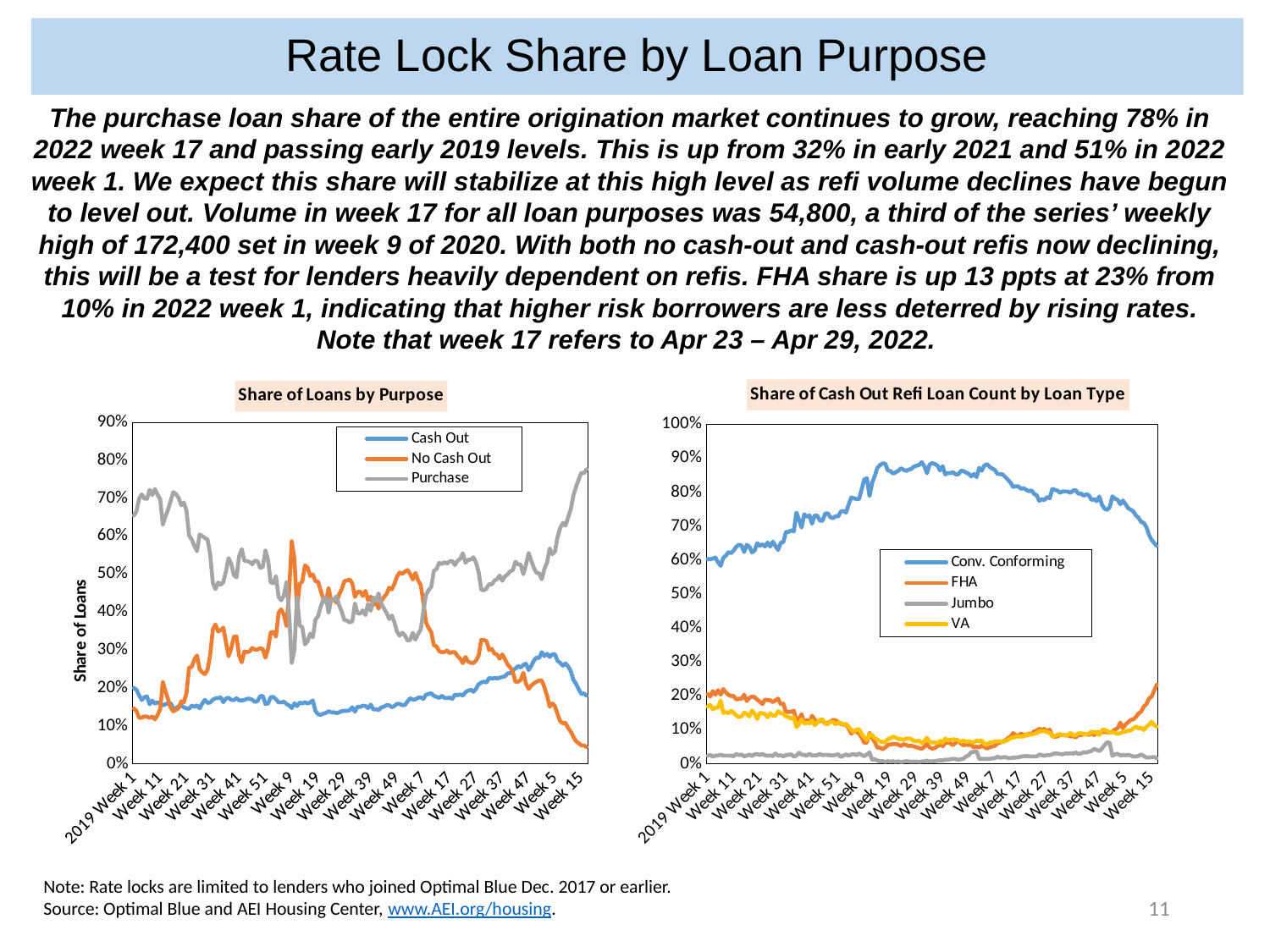
In the left chart "Share of Loans by Purpose", what are the three legend entries? Cash Out, No Cash Out, Purchase In the left chart "Share of Loans by Purpose", which series is higher at 2019 Week 1, Purchase or Cash Out? Purchase How many series does the legend of the right chart "Share of Cash Out Refi Loan Count by Loan Type" list? 4 In the left chart "Share of Loans by Purpose", is the Cash Out value at 2019 Week 1 greater or less than 30%? less In the right chart "Share of Cash Out Refi Loan Count by Loan Type", which series is higher at the final week of the series, Conv. Conforming or FHA? Conv. Conforming In the right chart "Share of Cash Out Refi Loan Count by Loan Type", is the Jumbo value at the final week of the series greater or less than 10%? less How many series does the legend of the left chart "Share of Loans by Purpose" list? 3 In the right chart "Share of Cash Out Refi Loan Count by Loan Type", does the FHA line rise or fall over the final weeks of the series? rise In the right chart "Share of Cash Out Refi Loan Count by Loan Type", is the Conv. Conforming value at 2019 Week 1 greater or less than 50%? greater What kind of chart is the left chart titled "Share of Loans by Purpose"? Line chart In the left chart "Share of Loans by Purpose", what is the y-axis title? Share of Loans